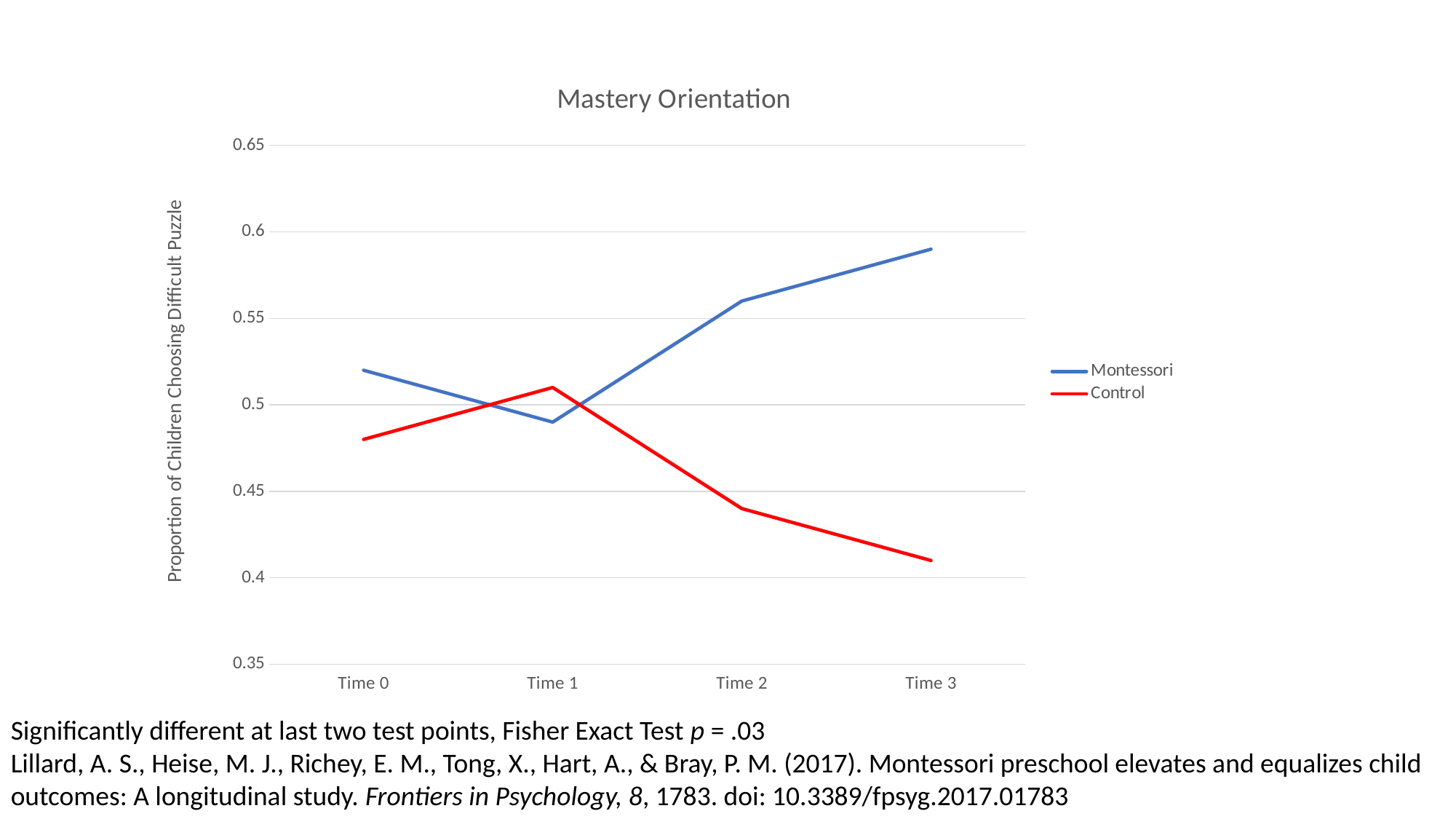
Is the Control value at Time 0 greater or less than 0.5? less At which time point does the Montessori series reach its highest value? Time 3 Does the Control series rise or fall from Time 1 to Time 3? fall What kind of chart is shown on the slide? line chart How many time points are plotted along the x axis? 4 At which time point does the Control series reach its highest value? Time 1 Is the Montessori value at Time 3 greater or less than 0.55? greater How many series does the legend list? 2 At which time point does the Control series reach its lowest value? Time 3 Which series has the higher value at Time 3, Montessori or Control? Montessori Is the Control value at Time 3 greater or less than 0.45? less What is the title of the chart? Mastery Orientation